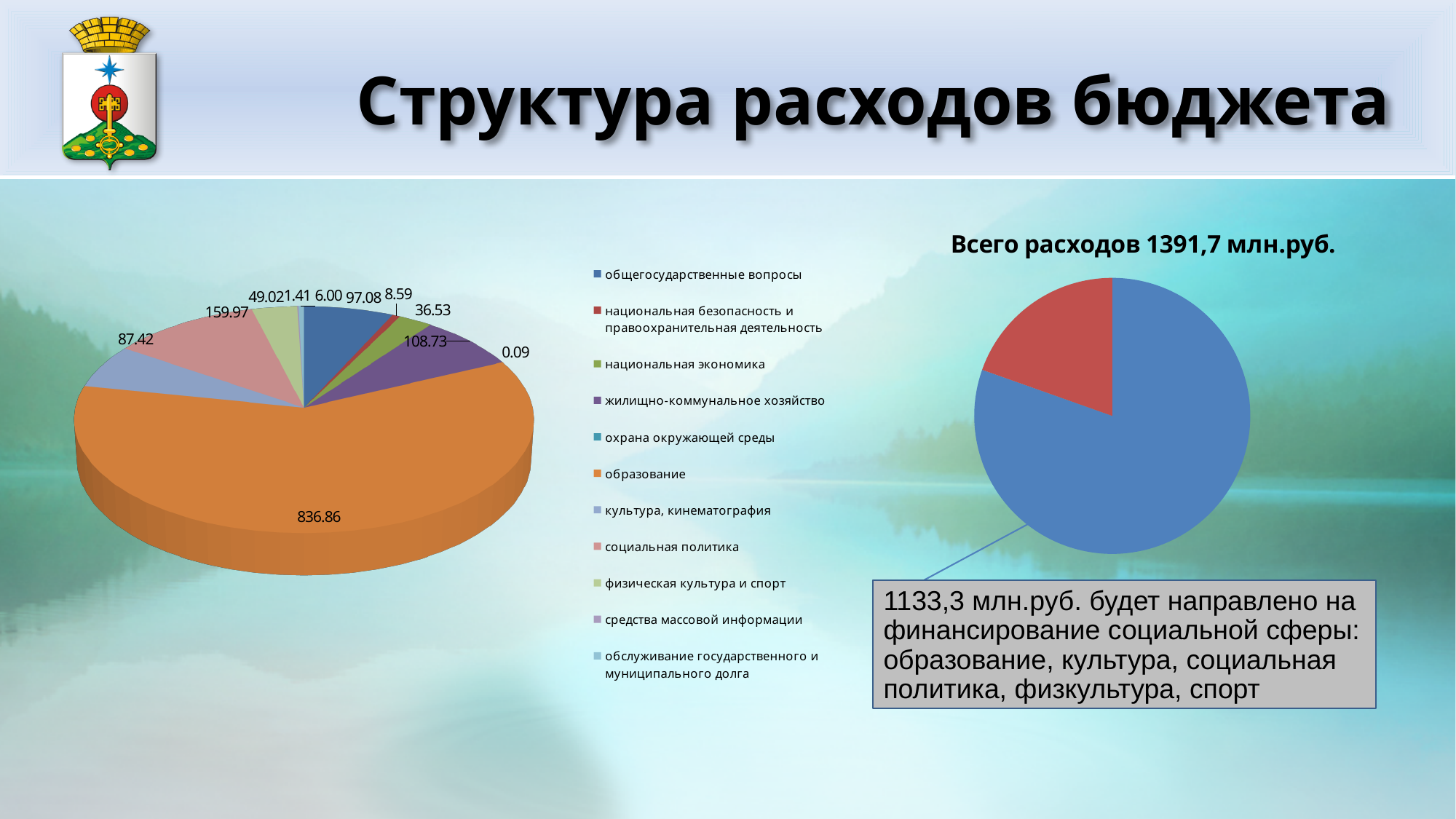
On the left pie chart, which category has the largest value? образование What type of chart is shown on the left of the slide? pie chart On the left pie chart, what is the value for жилищно-коммунальное хозяйство? 108.73 How many categories does the legend of the left pie chart list? 11 On the left pie chart, what is the value for социальная политика? 159.97 How many slices does the pie chart on the right of the slide have? 2 On the left pie chart, which category has the smallest value? охрана окружающей среды What is the title above the pie chart on the right of the slide? Всего расходов 1391,7 млн.руб. On the left pie chart, which is larger: жилищно-коммунальное хозяйство or общегосударственные вопросы? жилищно-коммунальное хозяйство On the left pie chart, what is the value for образование? 836.86 On the left pie chart, what is the difference between социальная политика and культура, кинематография? 72.55 On the left pie chart, what is the value for охрана окружающей среды? 0.09